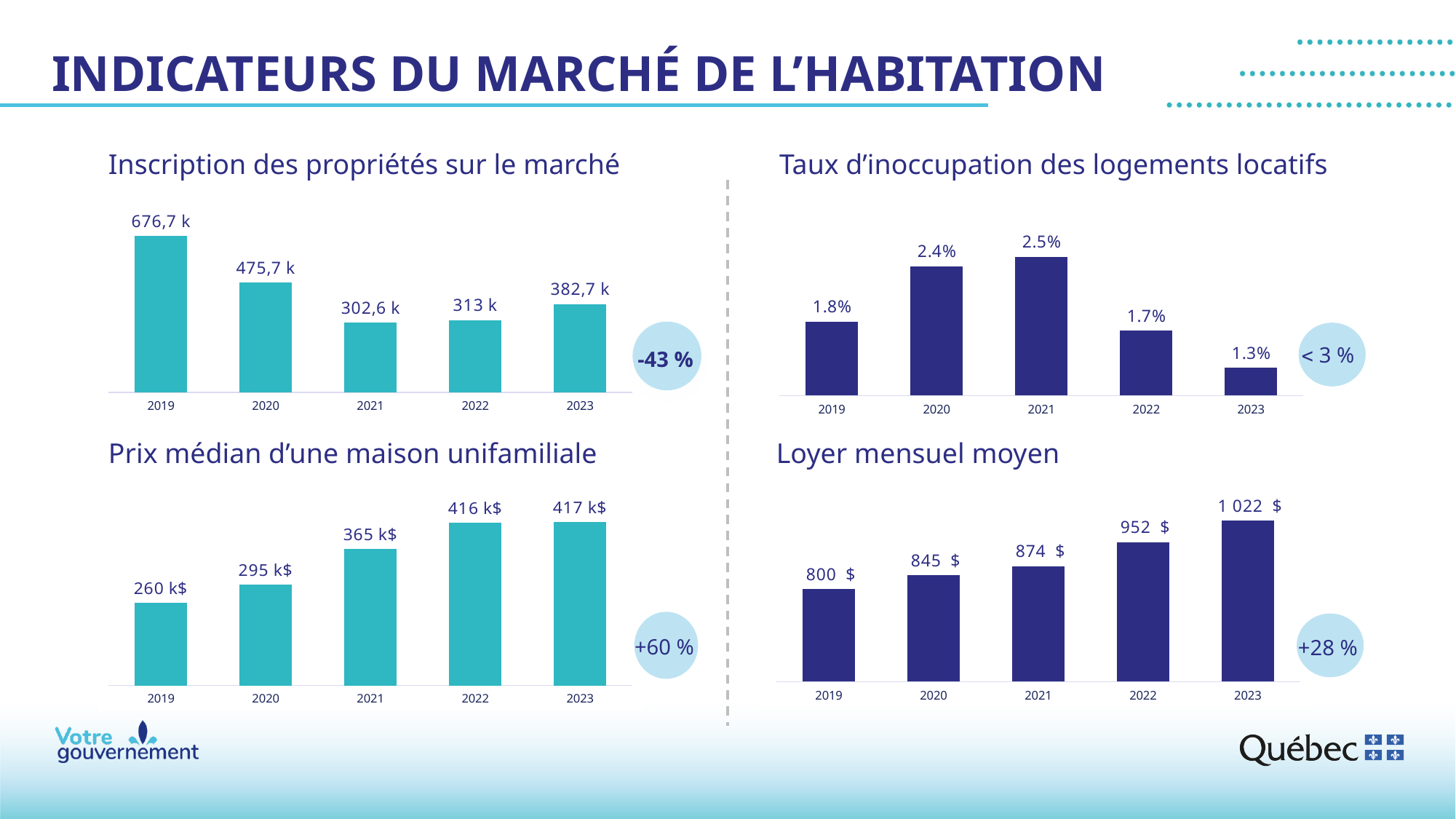
In the 'Loyer mensuel moyen' chart, what is the value for 2023? 1 022 $ In the 'Prix médian d'une maison unifamiliale' chart, do the values rise or fall from 2019 to 2023? rise In the 'Taux d'inoccupation des logements locatifs' chart, what is the value for 2023? 1.3% In the 'Taux d'inoccupation des logements locatifs' chart, which is larger, the value for 2019 or the value for 2022? 2019 In the 'Taux d'inoccupation des logements locatifs' chart, which year has the highest rate? 2021 In the 'Inscription des propriétés sur le marché' chart, which year has the lowest value? 2021 In the 'Inscription des propriétés sur le marché' chart, what is the value for 2019? 676,7 k In the 'Inscription des propriétés sur le marché' chart, what is the difference between the 2019 and 2023 values? 294 k In the 'Prix médian d'une maison unifamiliale' chart, what is the difference between the 2022 and 2019 values? 156 k$ In the 'Loyer mensuel moyen' chart, how many years are shown on the x axis? 5 What kind of chart is the 'Loyer mensuel moyen' chart? bar chart In the 'Prix médian d'une maison unifamiliale' chart, what is the value for 2021? 365 k$